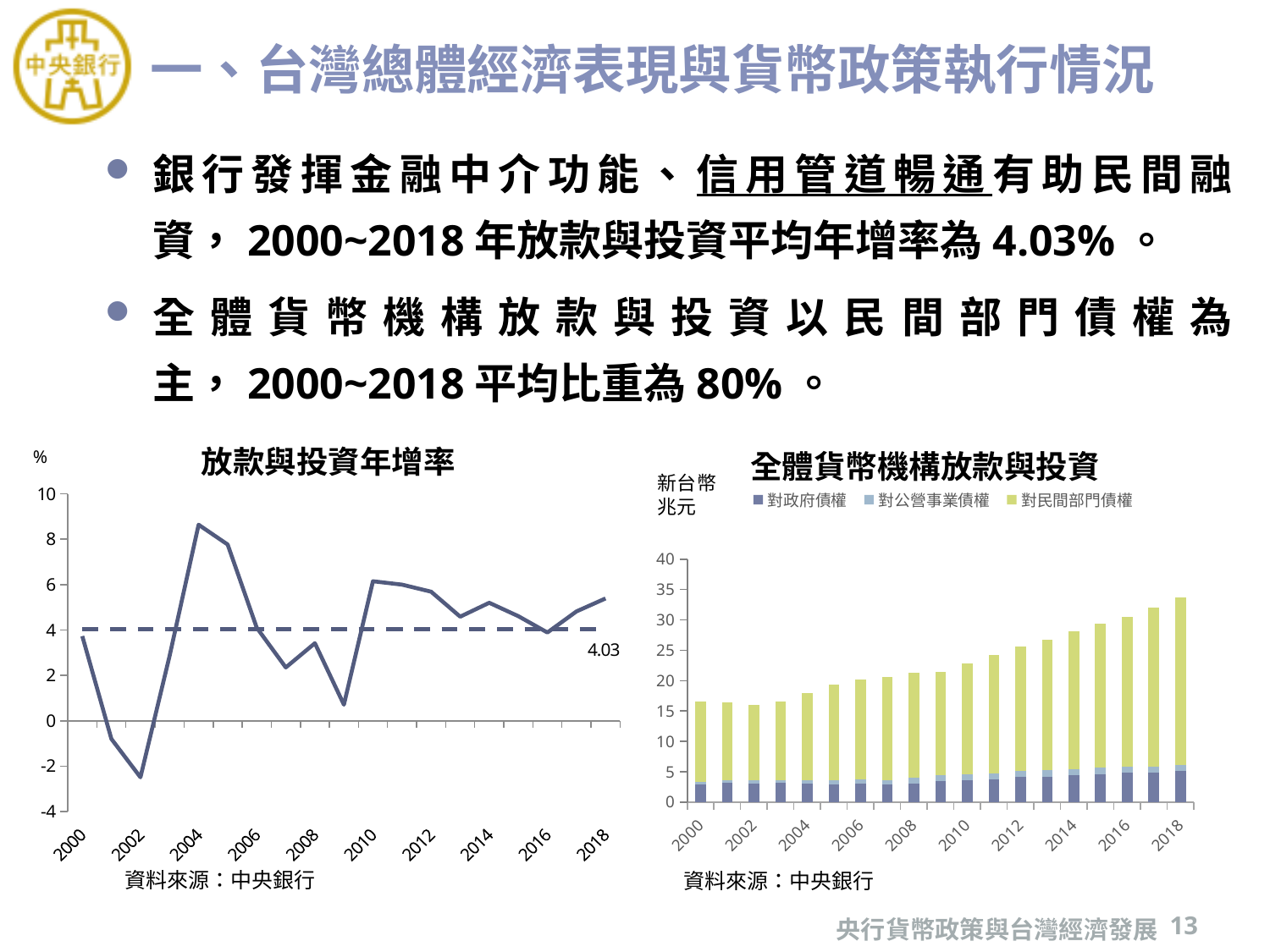
In the left chart 放款與投資年增率, which year has the lowest annual growth rate? 2002 In the right chart 全體貨幣機構放款與投資, which series makes up the largest part of each bar? 對民間部門債權 How many series does the legend of the right chart 全體貨幣機構放款與投資 list? 3 In the left chart 放款與投資年增率, is the value for 2004 greater or less than 8? greater In the right chart 全體貨幣機構放款與投資, what unit is shown on the vertical axis? 新台幣兆元 What kind of chart is the right chart titled 全體貨幣機構放款與投資? stacked bar chart What kind of chart is the left chart titled 放款與投資年增率? line chart In the left chart 放款與投資年增率, which year has the highest annual growth rate? 2004 In the left chart 放款與投資年增率, what value is labelled on the dashed horizontal line? 4.03 In the right chart 全體貨幣機構放款與投資, is the total for 2018 greater or less than 30? greater In the right chart 全體貨幣機構放款與投資, do the total bar heights generally rise or fall from 2000 to 2018? rise In the left chart 放款與投資年增率, is the value for 2009 greater or less than 2? less